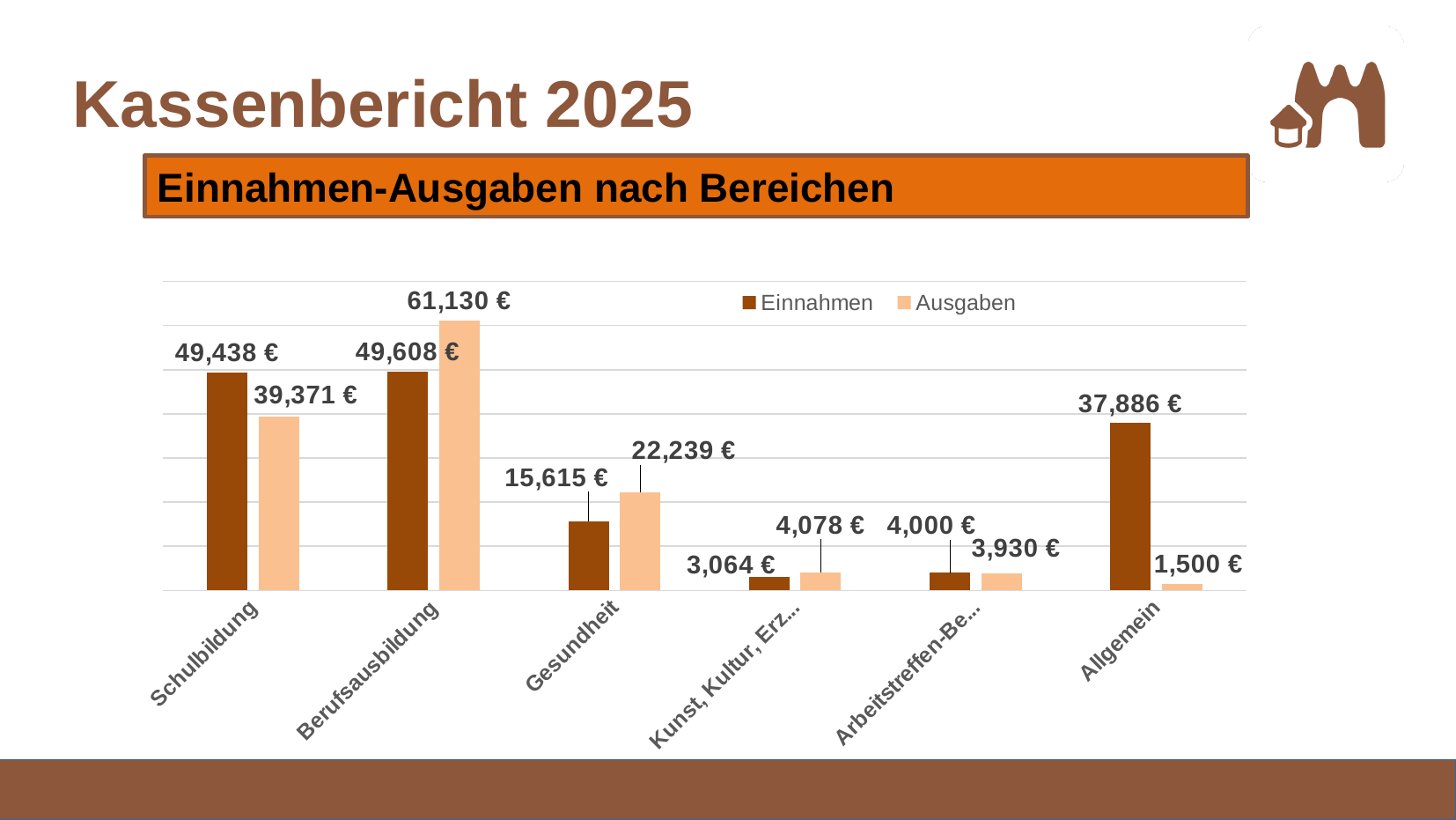
For Gesundheit, which is larger: Einnahmen or Ausgaben? Ausgaben Which category has the lowest Ausgaben value? Allgemein What is the Ausgaben value for Gesundheit? 22,239 € What is the Ausgaben value for Berufsausbildung? 61,130 € What is the difference between Einnahmen and Ausgaben for Allgemein? 36,386 € What kind of chart is shown on the slide? Bar chart What is the Einnahmen value for Allgemein? 37,886 € Which category has the highest Ausgaben value? Berufsausbildung What is the Einnahmen value for Schulbildung? 49,438 € How many series does the legend list? 2 How many categories are shown on the x axis? 6 What is the difference between Ausgaben and Einnahmen for Berufsausbildung? 11,522 €